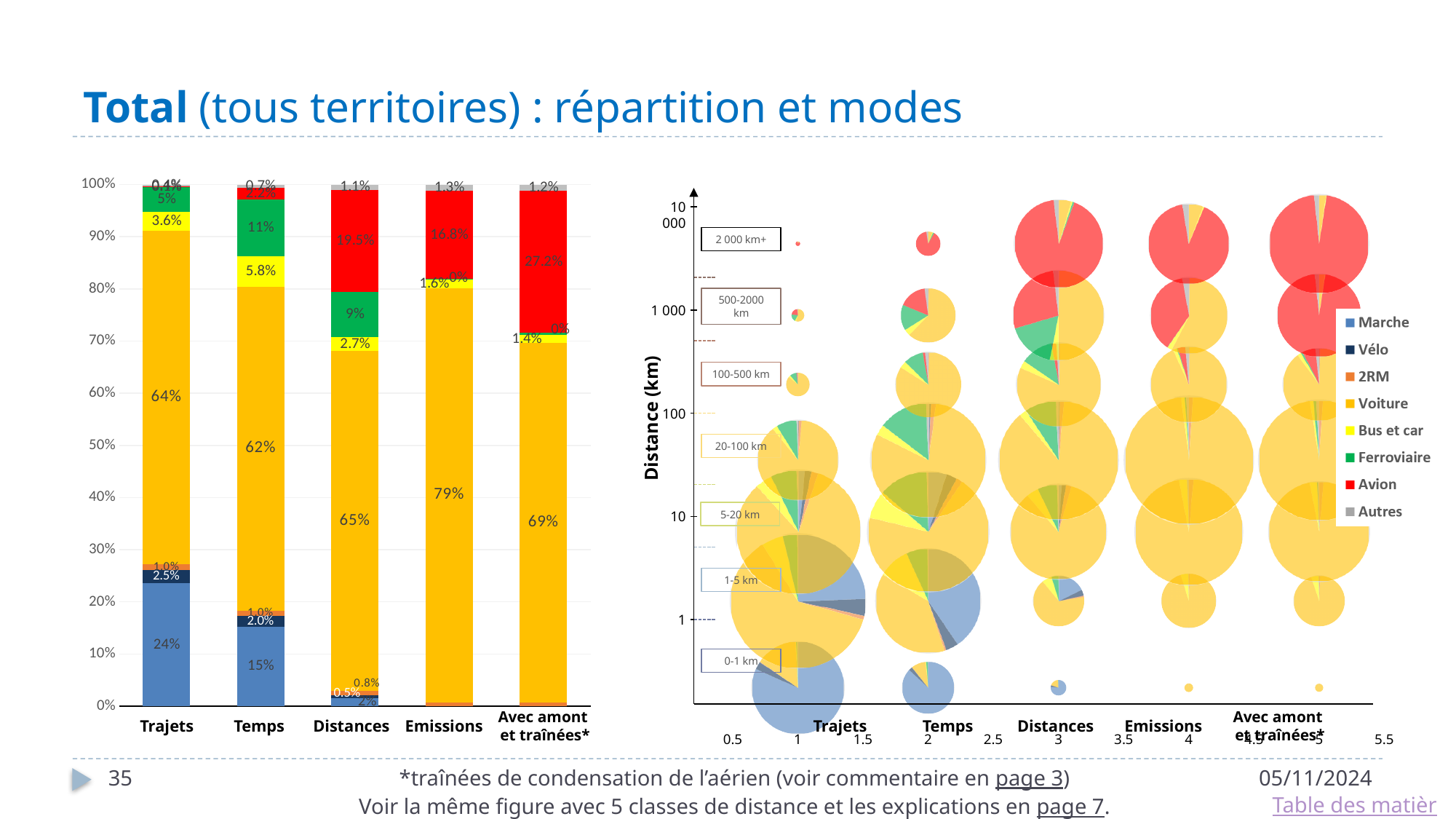
How many series does the legend of the right-hand bubble chart list? 8 In the left bar chart, what is the value of the yellow (Bus et car) segment for Distances? 2.7% In the left bar chart, what is the value of the large orange (Voiture) segment for Emissions? 79% In the left bar chart, what is the difference between the red (Avion) segment for Avec amont et traînées* and for Distances? 7.7% In the left bar chart, which category has the largest orange (Voiture) segment? Emissions What is the label of the y axis of the right-hand bubble chart? Distance (km) In the left bar chart, what is the value of the blue (Marche) segment for Trajets? 24% In the left bar chart, what is the value of the green (Ferroviaire) segment for Temps? 11% In the left bar chart, what is the value of the red (Avion) segment for Avec amont et traînées*? 27.2% How many categories are shown on the x axis of the left bar chart? 5 What kind of chart is the chart on the left of the slide? bar chart In the left bar chart, is the blue (Marche) segment larger for Trajets or for Temps? Trajets